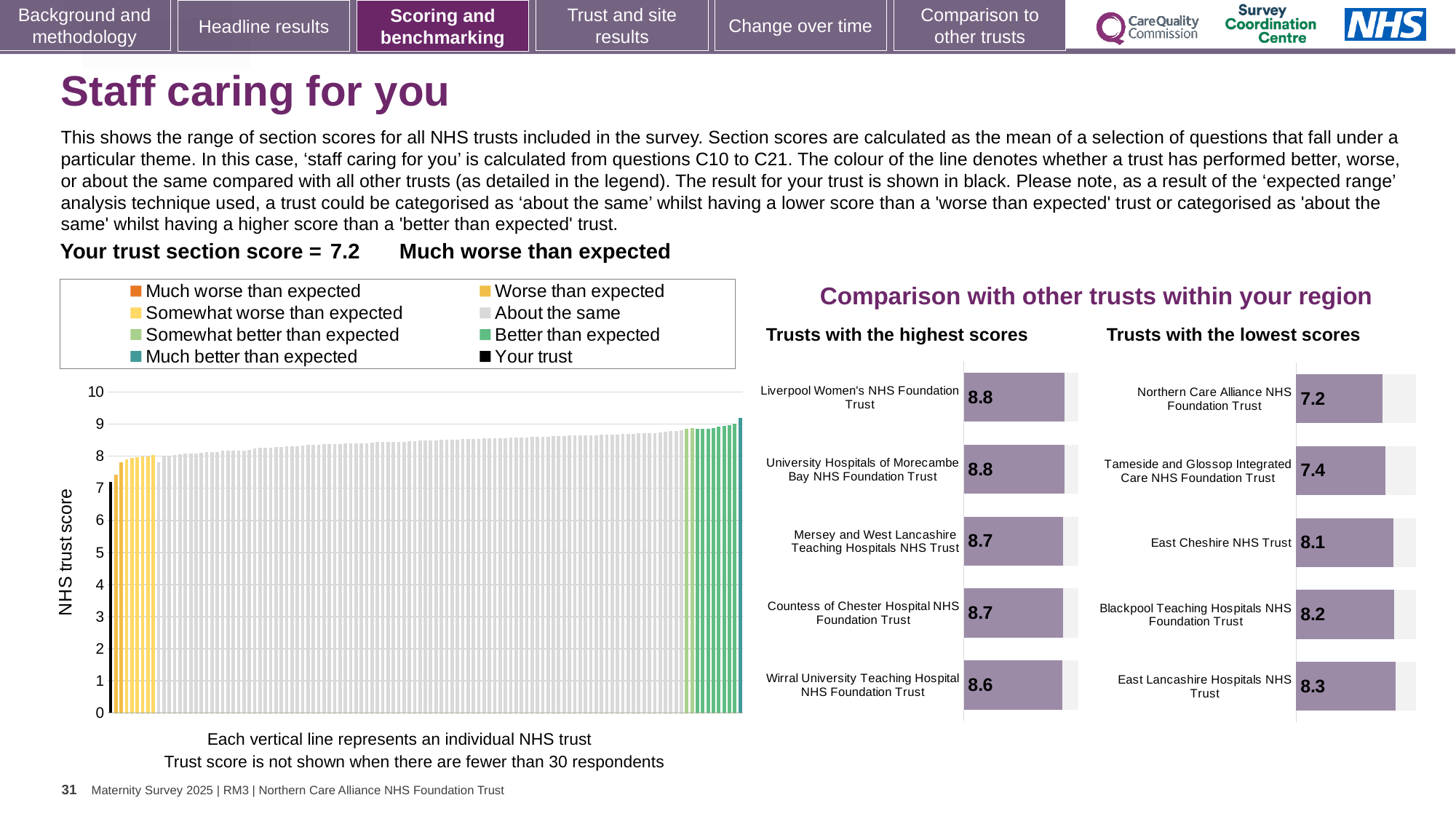
In the 'Trusts with the lowest scores' chart, which trust has the lowest score? Northern Care Alliance NHS Foundation Trust How many entries does the legend above the large chart on the left list? 8 What kind of chart is the large chart on the left showing all NHS trusts? Bar chart In the 'Trusts with the lowest scores' chart, what is the difference between the scores of East Lancashire Hospitals NHS Trust and Northern Care Alliance NHS Foundation Trust? 1.1 In the 'Trusts with the highest scores' chart, which has the higher score: Mersey and West Lancashire Teaching Hospitals NHS Trust or Wirral University Teaching Hospital NHS Foundation Trust? Mersey and West Lancashire Teaching Hospitals NHS Trust In the 'Trusts with the lowest scores' chart, what is the difference between the scores of Tameside and Glossop Integrated Care NHS Foundation Trust and Northern Care Alliance NHS Foundation Trust? 0.2 What is the y-axis label of the large chart on the left? NHS trust score In the 'Trusts with the lowest scores' chart, which trust has the highest score? East Lancashire Hospitals NHS Trust How many trusts are shown in the 'Trusts with the lowest scores' chart? 5 In the large chart on the left, is the value for the black 'Your trust' bar greater or less than 8? less In the 'Trusts with the lowest scores' chart, what is the score for East Cheshire NHS Trust? 8.1 In the 'Trusts with the highest scores' chart, what is the score for Wirral University Teaching Hospital NHS Foundation Trust? 8.6